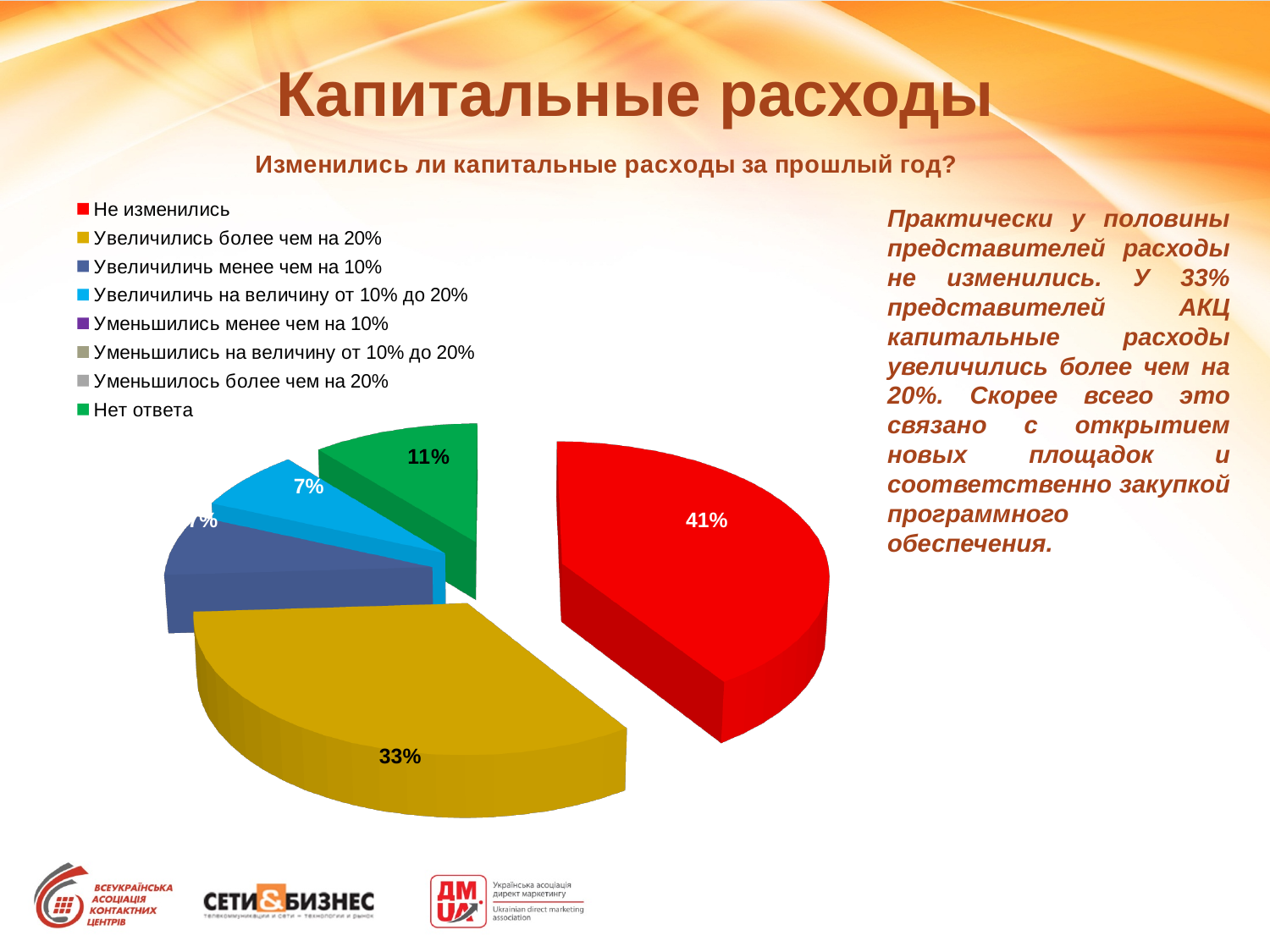
What share of the pie is labelled for "Увеличиличь на величину от 10% до 20%"? 7% By how many percentage points does the "Увеличились более чем на 20%" slice exceed the "Нет ответа" slice? 22 percentage points How many entries does the legend list? 8 What share of the pie is labelled for "Увеличились более чем на 20%"? 33% What share of the pie is labelled for "Нет ответа"? 11% What share of the pie is labelled for "Не изменились"? 41% What question is written above the chart as its subtitle? Изменились ли капитальные расходы за прошлый год? Which category has the largest slice of the pie? Не изменились By how many percentage points does the "Не изменились" slice exceed the "Увеличились более чем на 20%" slice? 8 percentage points What colour is the "Не изменились" slice? Red What kind of chart is shown on the slide? Pie chart Which slice is larger: "Нет ответа" or "Увеличиличь на величину от 10% до 20%"? Нет ответа